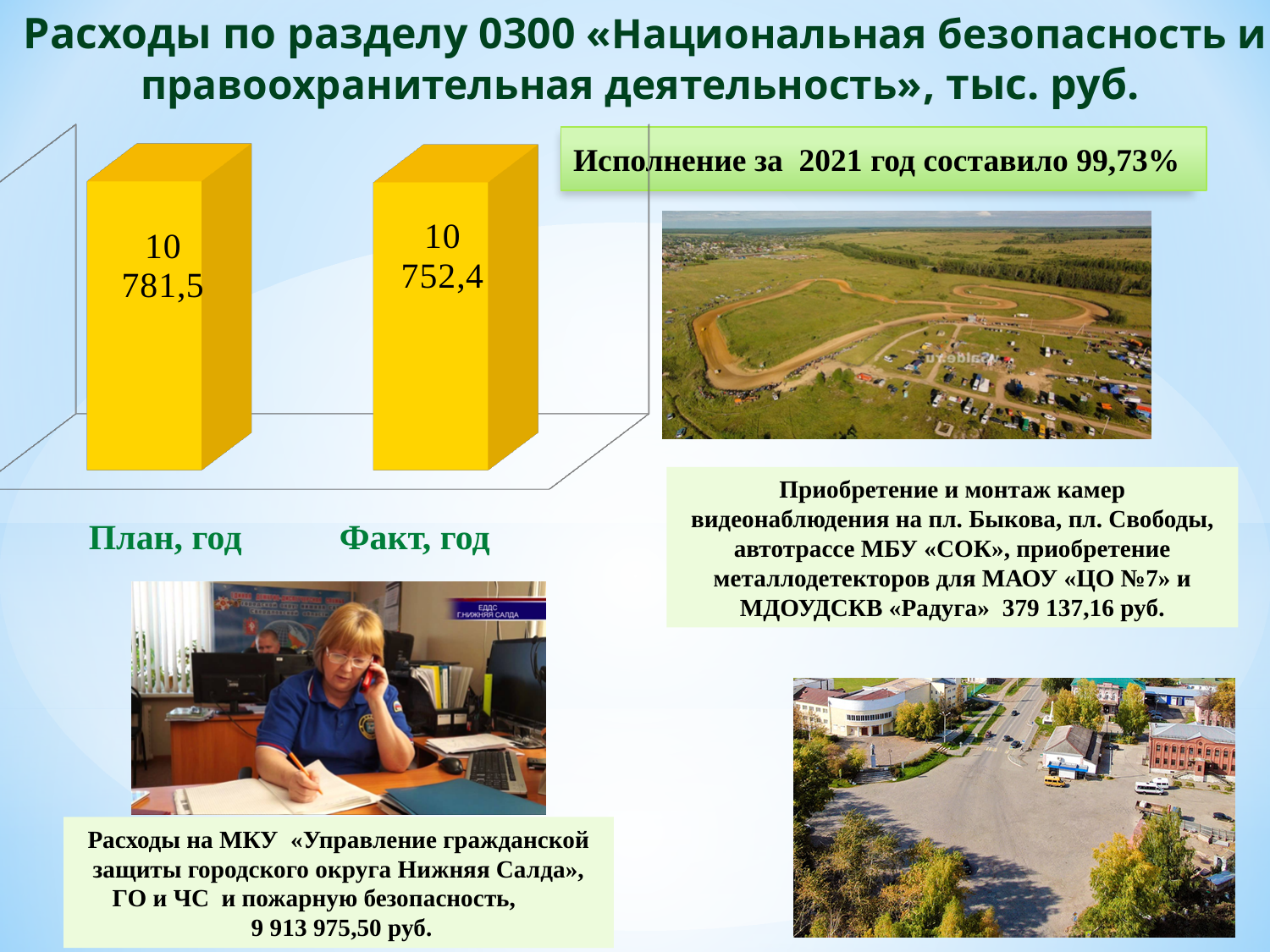
What is the value of the План, год bar? 10 781,5 In what units are the chart values expressed, according to the slide title? тыс. руб. How many bars are shown in the chart? 2 Do the values fall or rise from План, год to Факт, год? Fall What type of chart is shown on the slide? Bar chart What is the difference between the План, год and Факт, год values? 29,1 What is the value of the Факт, год bar? 10 752,4 Which bar is higher, План, год or Факт, год? План, год Which category has the lowest value in the chart? Факт, год Which category has the highest value in the chart? План, год What colour are the bars in the chart? Yellow